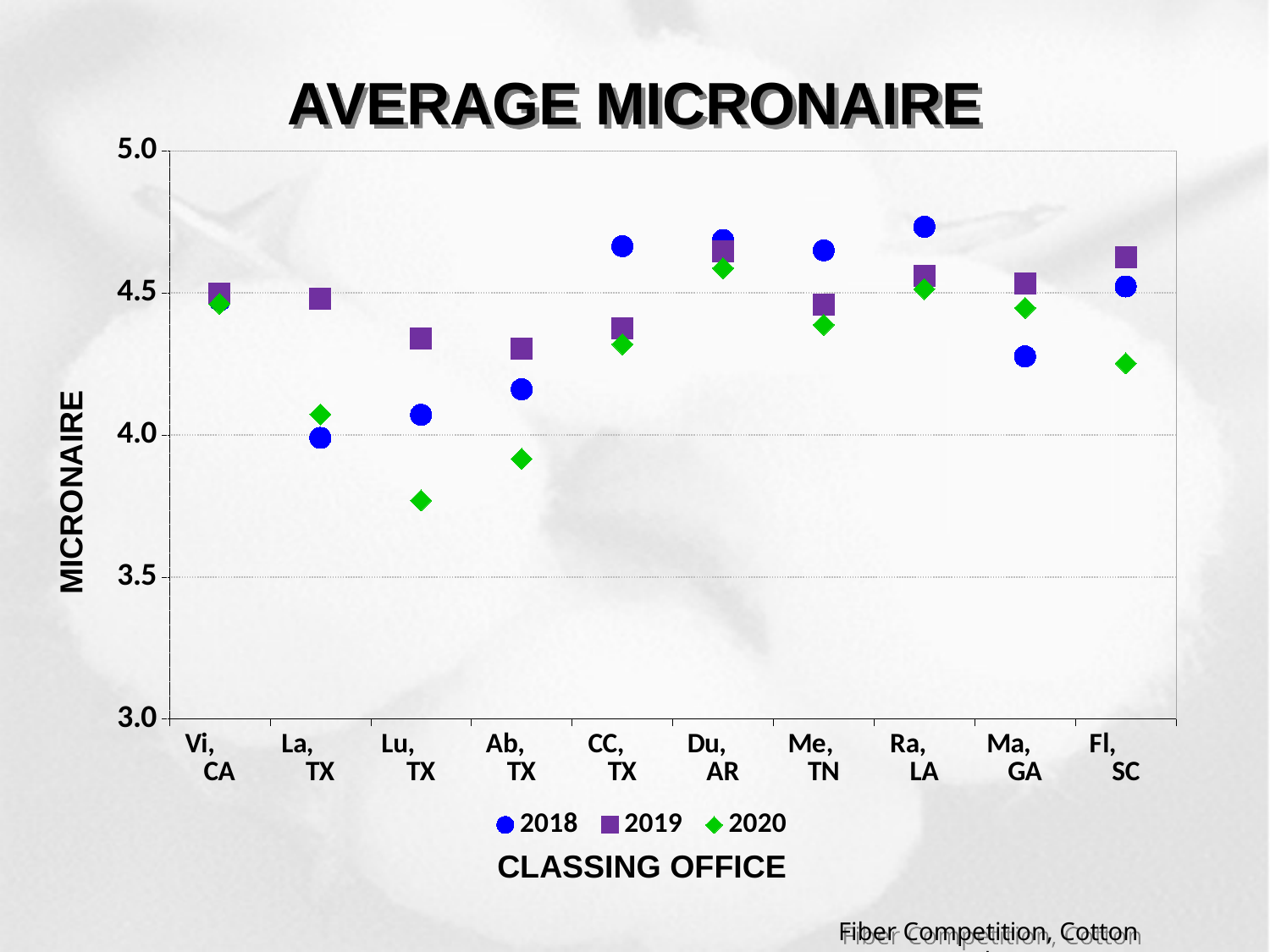
What is the title of the chart? AVERAGE MICRONAIRE How many classing offices are shown on the x axis? 10 For Fl, SC, which is larger: the 2018 value or the 2020 value? 2018 Is the 2018 value for CC, TX greater or less than 4.5? greater What kind of chart is this? Scatter (dot) chart Which classing office has the lowest 2020 value? Lu, TX What is the label of the x axis? CLASSING OFFICE For Ma, GA, which is larger: the 2018 value or the 2019 value? 2019 Is the 2020 value for Ab, TX greater or less than 4.0? less How many series does the legend list? 3 Is the 2018 value for Ma, GA greater or less than 4.5? less